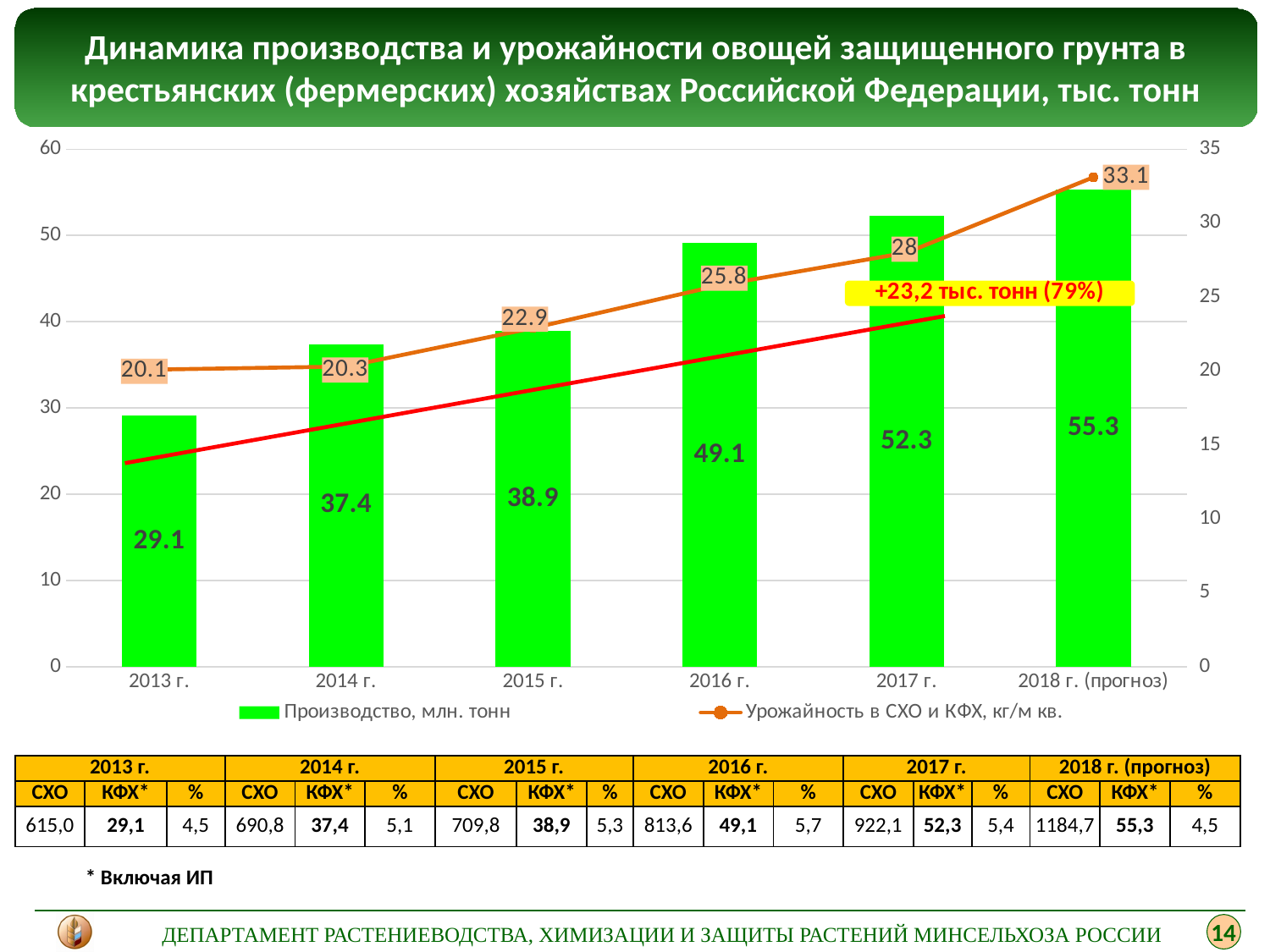
Which is larger, the Производство, млн. тонн value for 2014 г. or for 2015 г.? 2015 г. What is the Урожайность в СХО и КФХ, кг/м кв. value for 2015 г.? 22.9 What colour are the Производство, млн. тонн bars in the chart? green How many years are shown on the x axis of the chart? 6 What is the value of the Производство, млн. тонн bar for 2013 г.? 29.1 What is the Урожайность в СХО и КФХ, кг/м кв. value for 2018 г. (прогноз)? 33.1 Which year has the highest Производство, млн. тонн bar? 2018 г. (прогноз) What is the value of the Производство, млн. тонн bar for 2016 г.? 49.1 How many series does the chart legend list? 2 What is the difference between the Производство, млн. тонн values for 2017 г. and 2016 г.? 3.2 Do the Урожайность в СХО и КФХ, кг/м кв. values rise or fall from 2013 г. to 2018 г. (прогноз)? rise Which year has the lowest Урожайность в СХО и КФХ, кг/м кв. value? 2013 г.